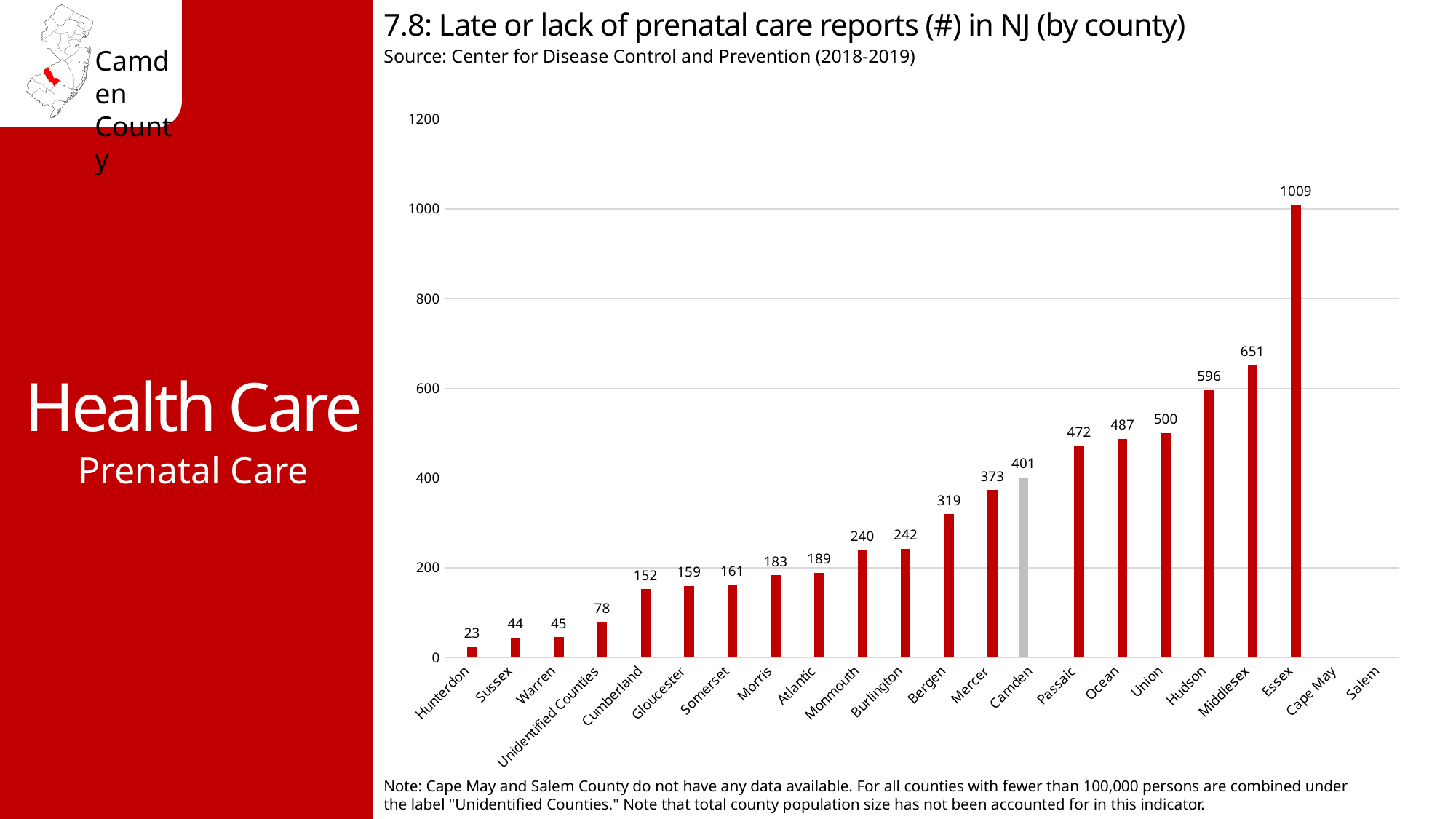
What is the value shown for Hunterdon? 23 What is the value shown for Essex? 1009 Which bar is shown in a different colour (grey) from the others? Camden Which county has the highest number of late or lack of prenatal care reports? Essex Is the value for Passaic greater or less than 400? greater What is the difference between the values for Essex and Middlesex? 358 What is the number of late or lack of prenatal care reports for Camden? 401 What is the difference between the values for Camden and Mercer? 28 Which county with a plotted bar has the lowest number of reports? Hunterdon Which has a higher value, Hudson or Union? Hudson Do the values generally rise or fall moving from left to right along the x axis? Rise What kind of chart is shown on the slide? Bar chart